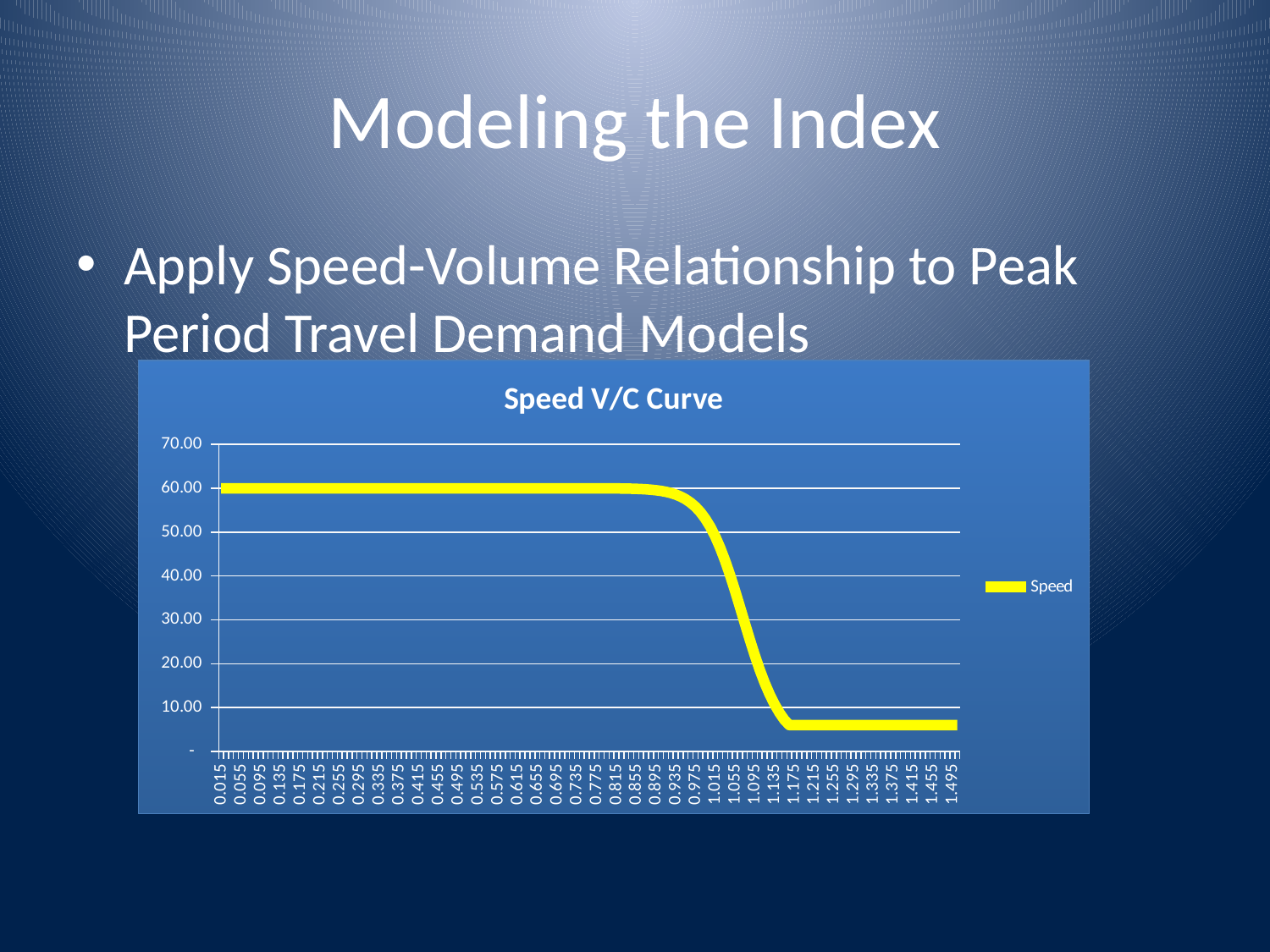
Which has the larger value, 0.255 or 1.335? 0.255 What kind of chart is shown on the slide? line chart Overall, do the Speed values rise or fall as you move along the x axis from 0.015 to 1.495? fall What is the name of the series shown in the legend? Speed Is the value for 0.735 greater or less than 40.00? greater Which has the larger value, 1.415 or 0.615? 0.615 Is the value for 1.495 greater or less than 10.00? less Is the value for 0.495 greater or less than 50.00? greater What is the title of the chart? Speed V/C Curve How many series does the chart's legend list? 1